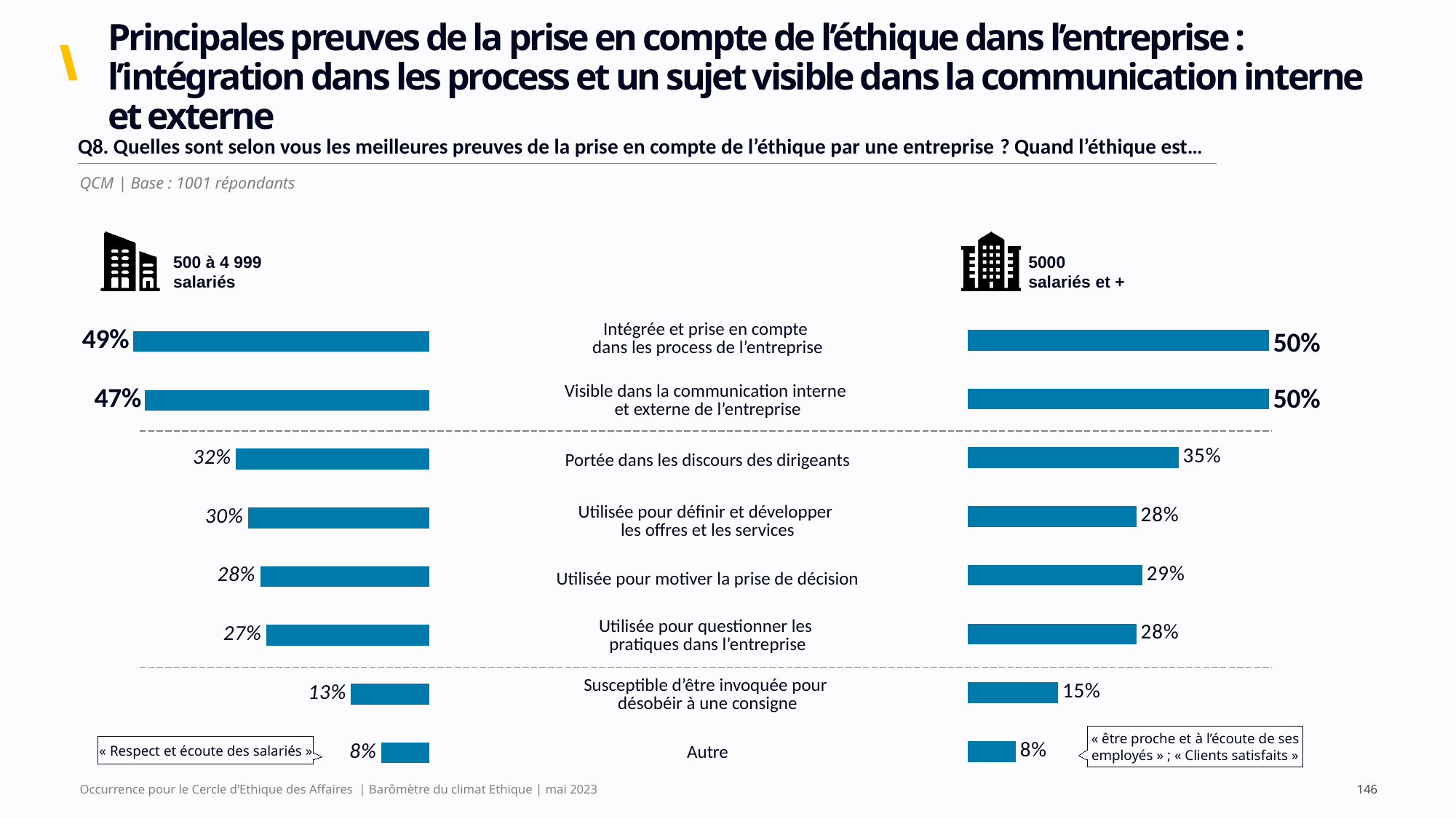
How many categories are plotted in the "500 à 4 999 salariés" chart? 8 In the "5000 salariés et +" chart, which category has the lowest value? Autre For "Portée dans les discours des dirigeants", which chart shows the larger value, "500 à 4 999 salariés" or "5000 salariés et +"? 5000 salariés et + In the "5000 salariés et +" chart, what is the difference between "Portée dans les discours des dirigeants" and "Susceptible d'être invoquée pour désobéir à une consigne"? 20 percentage points In the "5000 salariés et +" chart, what is the value for "Portée dans les discours des dirigeants"? 35% In the "5000 salariés et +" chart, what is the value for "Utilisée pour motiver la prise de décision"? 29% In the "500 à 4 999 salariés" chart, what is the value for "Intégrée et prise en compte dans les process de l'entreprise"? 49% What type of chart is used on this slide? Bar chart In the "500 à 4 999 salariés" chart, which category has the highest value? Intégrée et prise en compte dans les process de l'entreprise In the "500 à 4 999 salariés" chart, what is the difference between "Intégrée et prise en compte dans les process de l'entreprise" and "Visible dans la communication interne et externe de l'entreprise"? 2 percentage points In the "500 à 4 999 salariés" chart, what is the value for "Susceptible d'être invoquée pour désobéir à une consigne"? 13% In the "500 à 4 999 salariés" chart, what is the value for "Utilisée pour définir et développer les offres et les services"? 30%